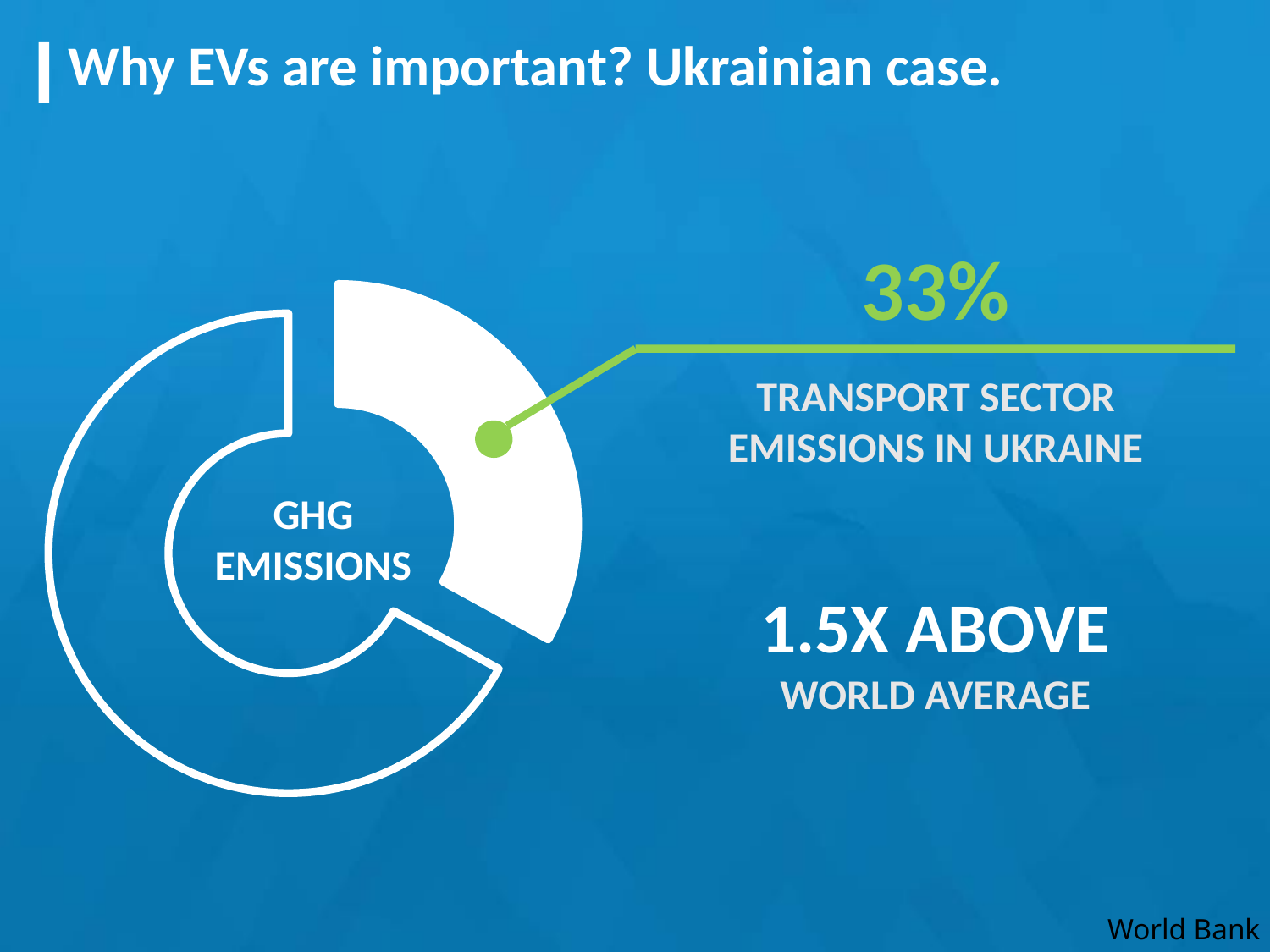
What kind of chart is shown on the slide? pie chart (donut) What label appears in the centre of the donut chart? GHG EMISSIONS Is the transport sector's share of GHG emissions greater or less than 50%? less Which segment of the donut chart is larger: the transport sector segment or the remaining segment? the remaining segment How many segments does the GHG emissions donut chart have? 2 How does Ukraine's transport sector emissions share compare to the world average, according to the slide? 1.5X above world average What share of GHG emissions in Ukraine does the transport sector account for, according to the chart? 33% What share of GHG emissions is represented by the non-transport (outlined) segment of the donut chart? 67% What is the source cited for the chart on the slide? World Bank